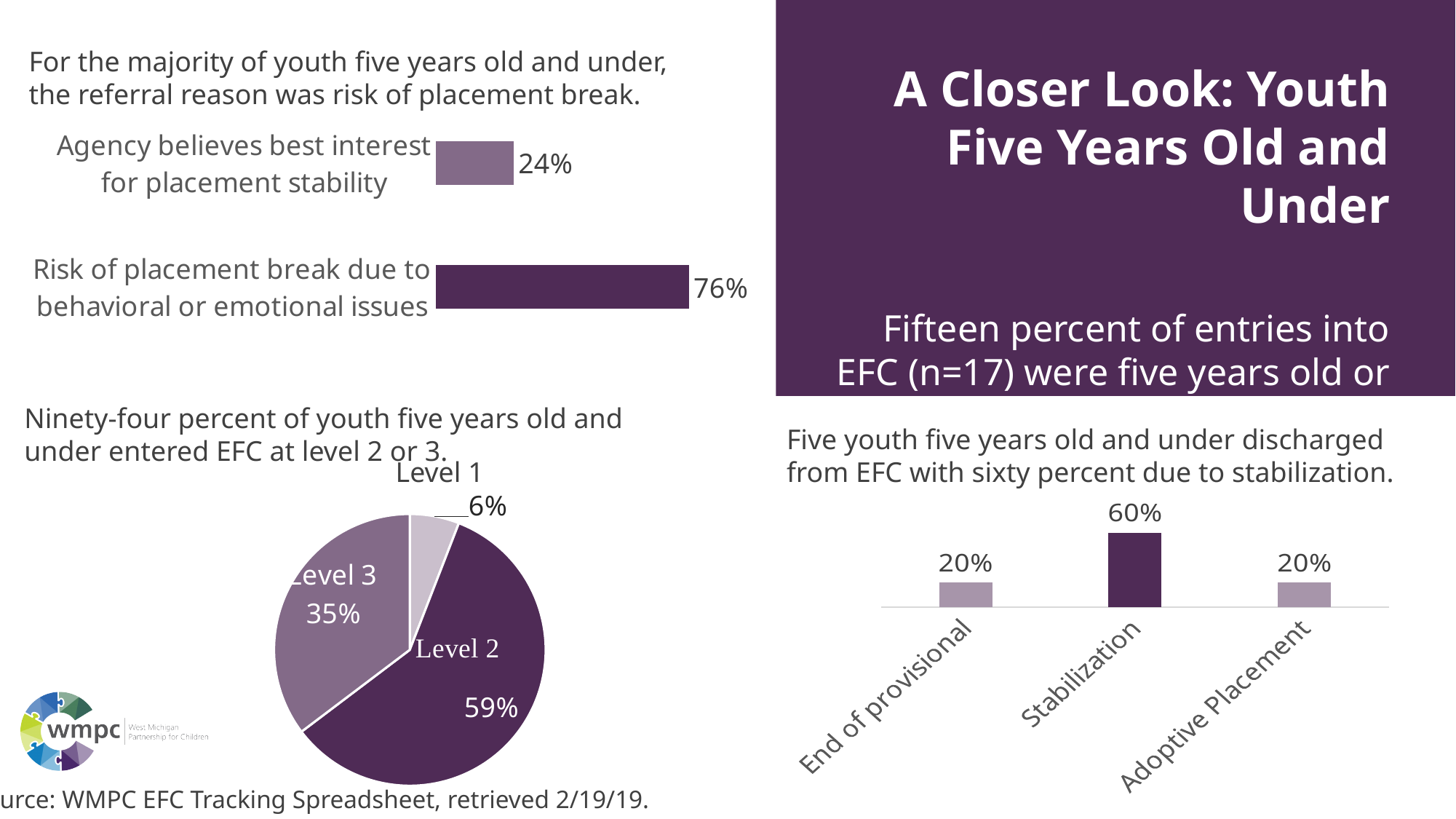
How many categories are shown in the bottom-right discharge bar chart? 3 In the bottom-left pie chart, what is the value for Level 3? 35% In the bottom-right discharge bar chart, which category has the highest value? Stabilization What kind of chart is the top-left referral reason chart? Bar chart In the bottom-left pie chart, what share does Level 2 have? 59% How many slices does the bottom-left pie chart have? 3 In the bottom-right discharge bar chart, what is the value for Stabilization? 60% In the top-left referral reason bar chart, what is the difference between the two bars? 52% In the top-left referral reason bar chart, what is the value for 'Risk of placement break due to behavioral or emotional issues'? 76% In the bottom-right discharge bar chart, what is the difference between Stabilization and Adoptive Placement? 40% In the bottom-left pie chart, which level has the smallest slice? Level 1 In the top-left referral reason bar chart, what is the value for 'Agency believes best interest for placement stability'? 24%